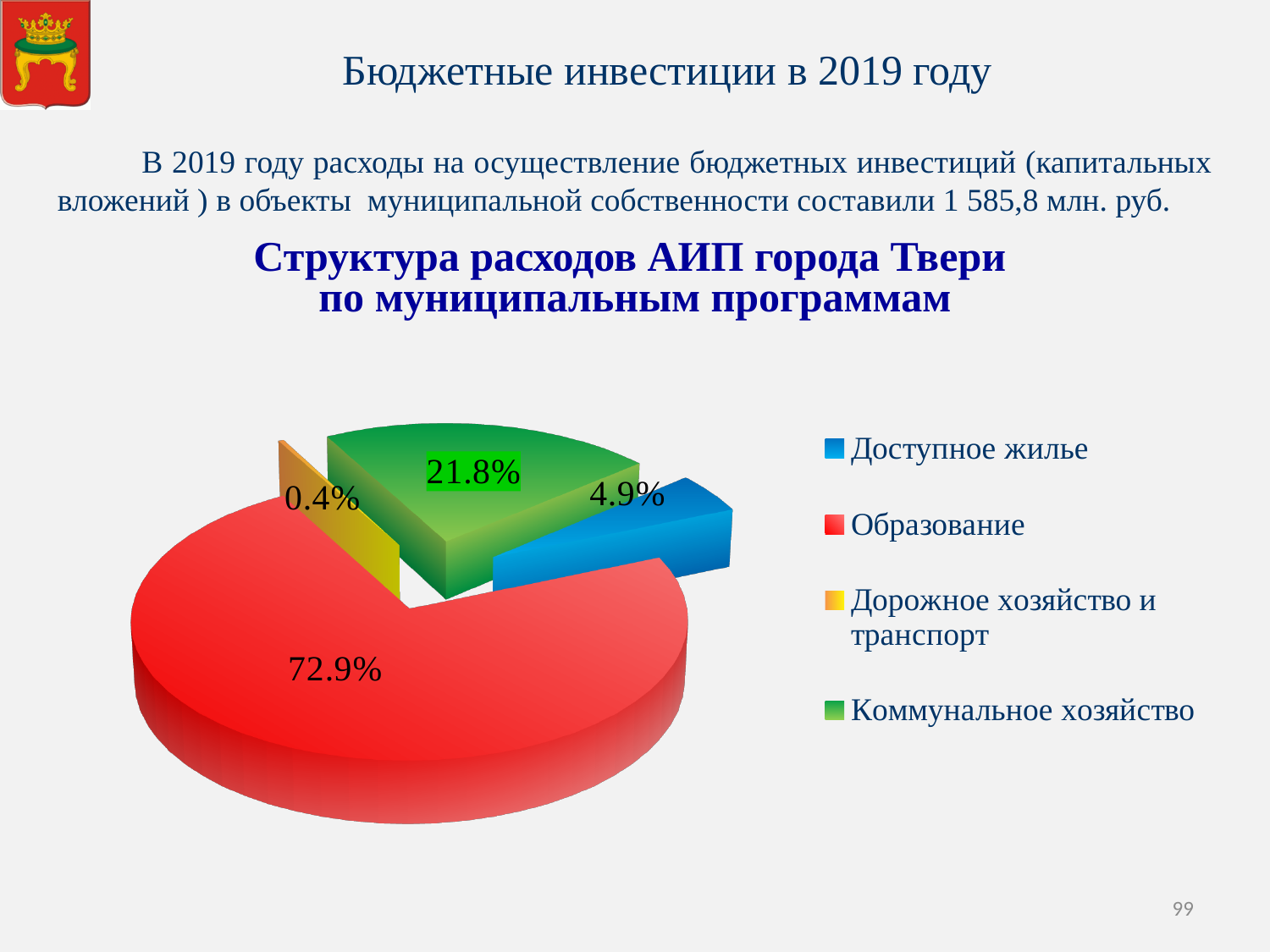
What share of the pie does Доступное жилье have? 4.9% What share of the pie does Образование have? 72.9% How many categories does the pie chart have? 4 Which category has the smallest slice of the pie? Дорожное хозяйство и транспорт What kind of chart is shown on the slide? Pie chart What colour is the slice for Образование? Red What is the title of the chart? Структура расходов АИП города Твери по муниципальным программам What share of the pie does Коммунальное хозяйство have? 21.8% Which category has the largest slice of the pie? Образование Which is larger, the share for Доступное жилье or the share for Коммунальное хозяйство? Коммунальное хозяйство What share of the pie does Дорожное хозяйство и транспорт have? 0.4% What is the difference in percentage points between Образование and Коммунальное хозяйство? 51.1